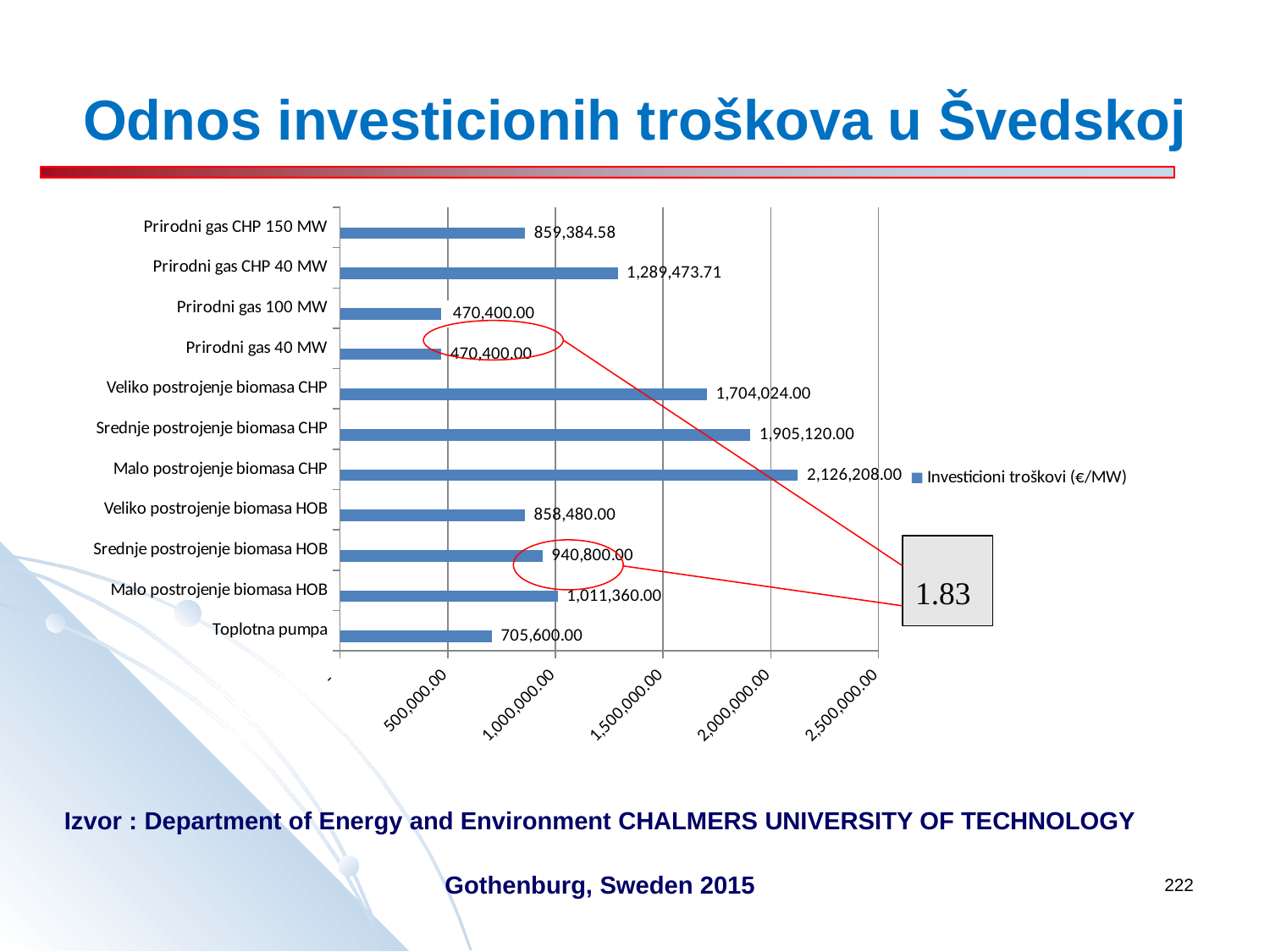
What is the difference between Malo postrojenje biomasa CHP and Srednje postrojenje biomasa CHP? 221,088.00 What is the legend entry of the chart? Investicioni troškovi (€/MW) Which is larger, Prirodni gas CHP 40 MW or Veliko postrojenje biomasa HOB? Prirodni gas CHP 40 MW Which category has the highest investment cost? Malo postrojenje biomasa CHP What is the difference between Malo postrojenje biomasa HOB and Toplotna pumpa? 305,760.00 Is the value for Veliko postrojenje biomasa CHP greater or less than 1,500,000.00? greater What kind of chart is shown on the slide? bar chart What is the value for Srednje postrojenje biomasa HOB? 940,800.00 How many categories are shown in the chart? 11 What is the value for Malo postrojenje biomasa CHP? 2,126,208.00 What is the value for Prirodni gas CHP 40 MW? 1,289,473.71 What is the value for Toplotna pumpa? 705,600.00